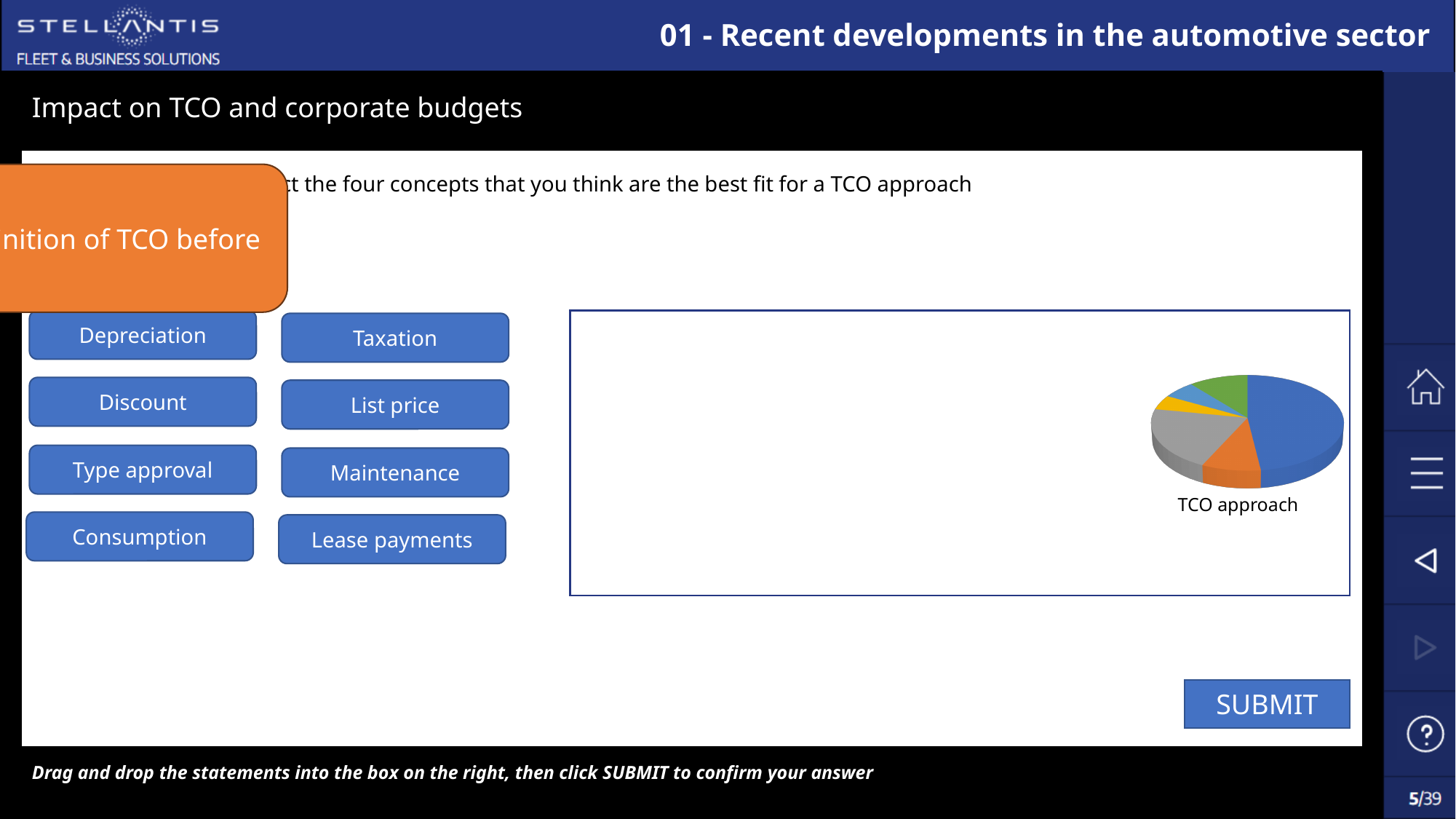
How many slices does the pie chart have? 6 What kind of chart is shown on the slide? pie chart Which is larger in the pie chart, the gray slice or the yellow slice? gray Which is larger in the pie chart, the blue slice or the orange slice? blue What is the title shown beneath the pie chart? TCO approach Does the pie chart display a legend or data labels for its slices? No Which colour slice is the largest in the pie chart? blue